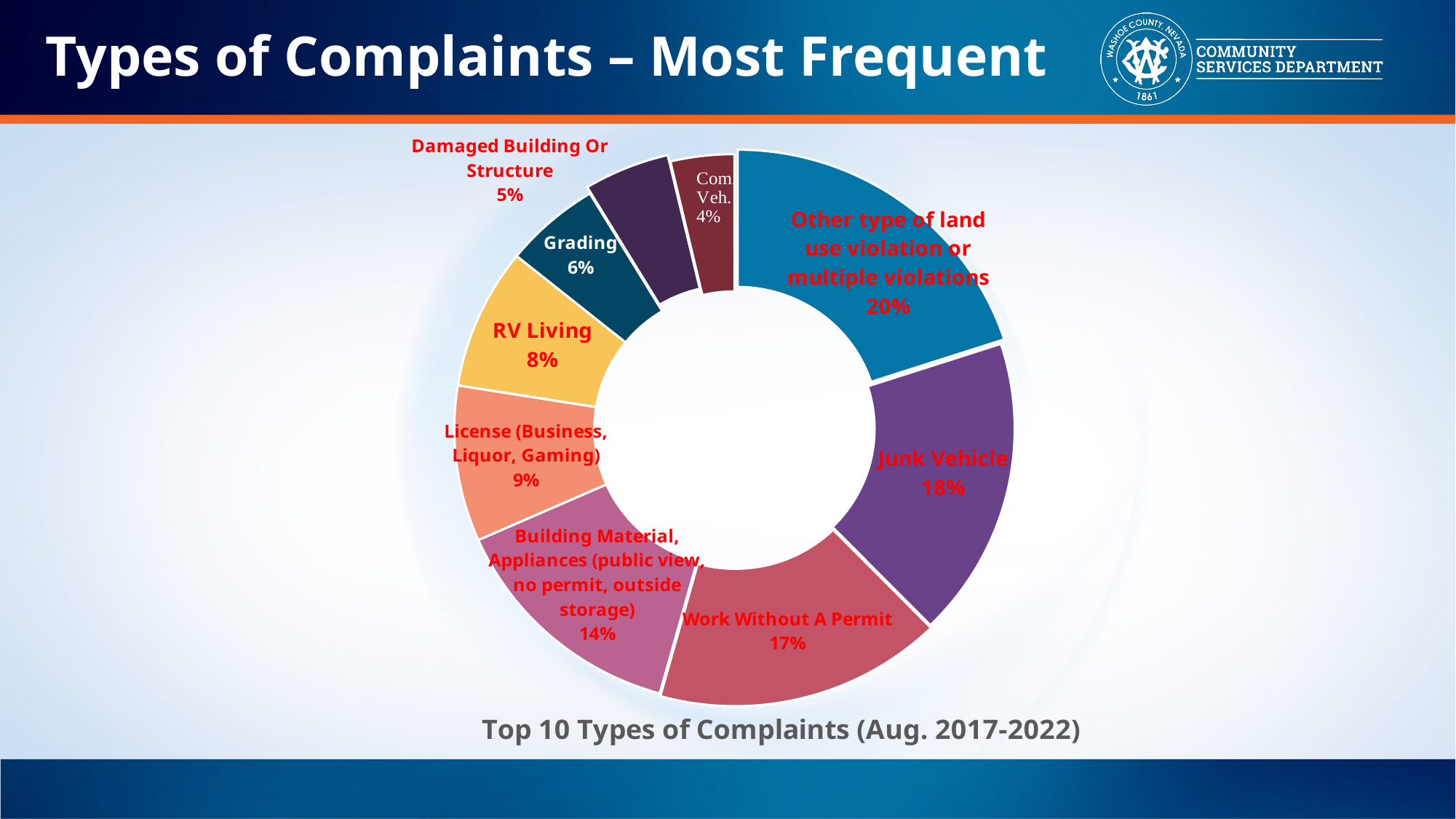
What share is shown for License (Business, Liquor, Gaming)? 9% What percentage is shown for Grading? 6% What is the caption below the chart? Top 10 Types of Complaints (Aug. 2017-2022) What percentage is shown for Work Without A Permit? 17% What share of complaints is Junk Vehicle? 18% Which complaint type has the smallest share? Com. Veh. Which has a larger share, Building Material, Appliances or License (Business, Liquor, Gaming)? Building Material, Appliances What share of complaints is RV Living? 8% What is the difference between the share for Other type of land use violation or multiple violations and the share for Damaged Building Or Structure? 15 percentage points What type of chart is shown on the slide? Pie chart (donut) Which complaint type has the largest share? Other type of land use violation or multiple violations What is the difference in percentage points between Junk Vehicle and Work Without A Permit? 1 percentage point